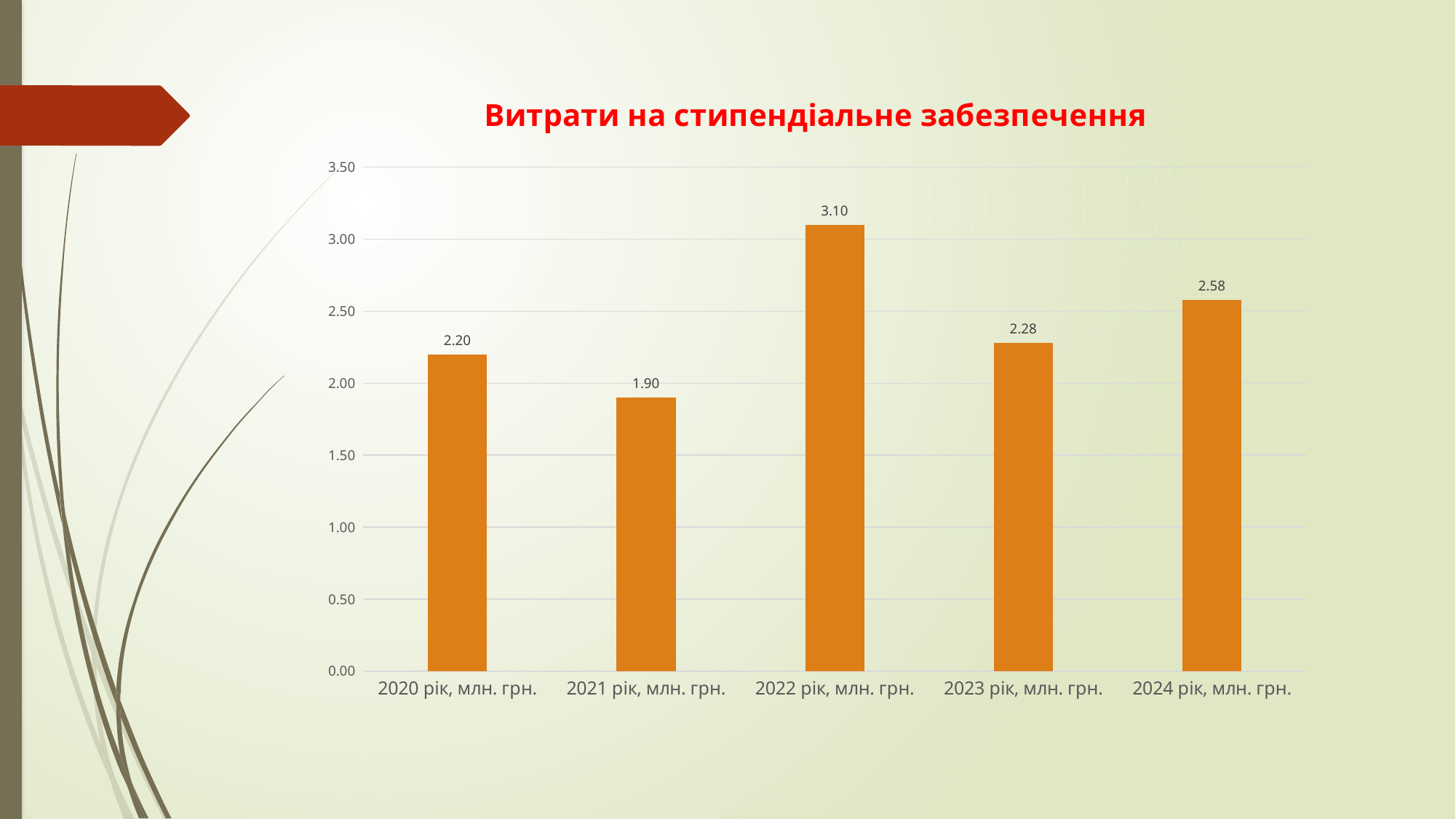
What is the value for 2020 рік, млн. грн.? 2.20 What is the title of the chart? Витрати на стипендіальне забезпечення What is the difference between the values for 2022 and 2021? 1.20 Which year has the highest value? 2022 рік, млн. грн. Is the value for 2021 greater or less than 2.00? less What is the difference between the values for 2024 and 2023? 0.30 How many bars are shown in the chart? 5 What kind of chart is shown on the slide? bar chart What is the value for 2024 рік, млн. грн.? 2.58 What is the value for 2022 рік, млн. грн.? 3.10 Which year has the lowest value? 2021 рік, млн. грн. Which is larger, the value for 2020 or the value for 2023? 2023 рік, млн. грн.